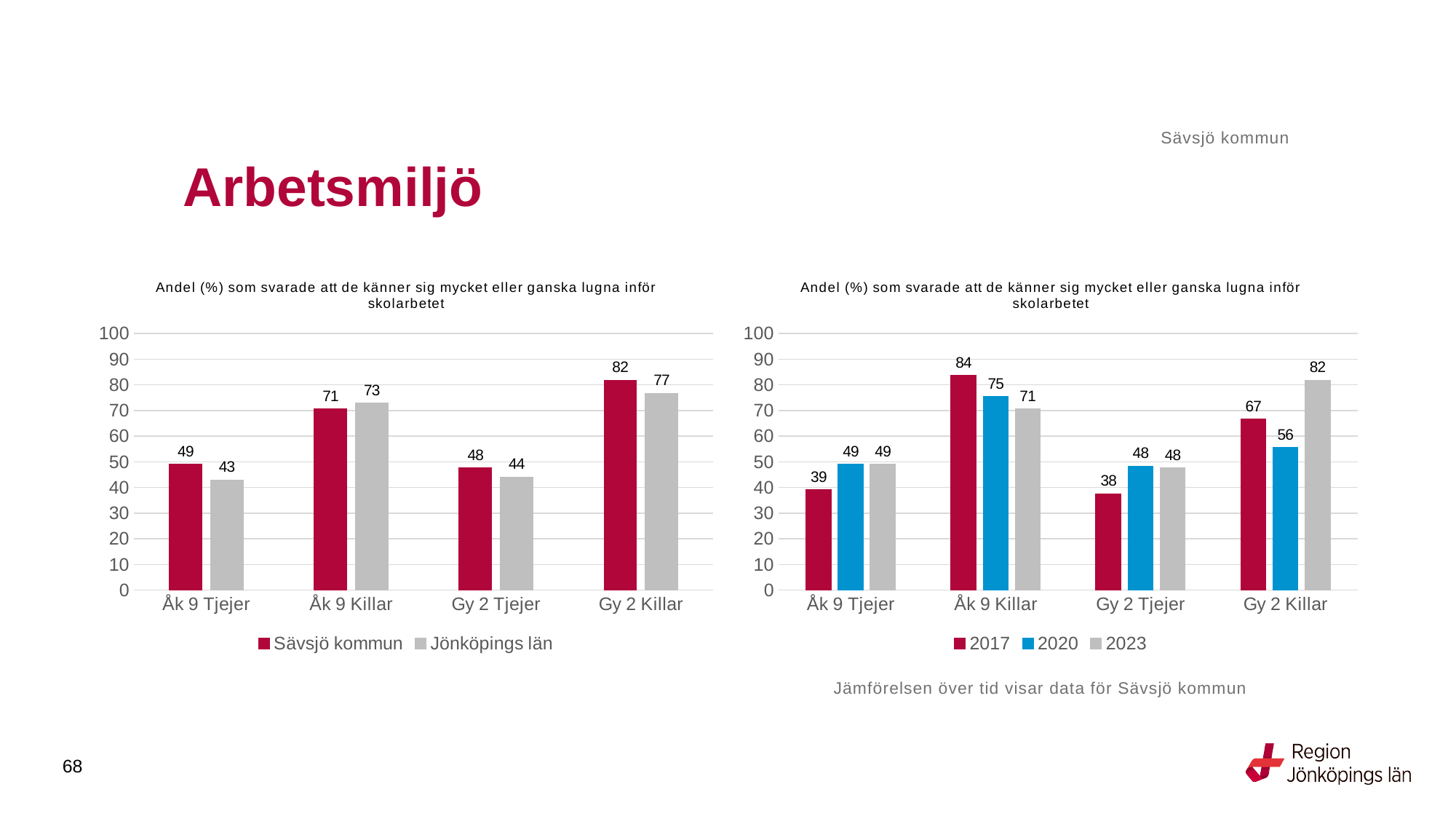
In the left chart, how many series does the legend list? 2 In the left chart, what is the value for Jönköpings län for Åk 9 Tjejer? 43 In the right chart, which category has the lowest value for 2017? Gy 2 Tjejer In the left chart, what is the difference between Sävsjö kommun and Jönköpings län for Gy 2 Killar? 5 In the right chart, what is the difference between 2017 and 2023 for Åk 9 Killar? 13 In the right chart, how many categories are shown on the x axis? 4 In the right chart, what is the value for 2023 for Gy 2 Killar? 82 In the left chart, what is the value for Sävsjö kommun for Gy 2 Killar? 82 In the left chart, which is larger for Åk 9 Killar: Sävsjö kommun or Jönköpings län? Jönköpings län In the right chart, what is the value for 2017 for Åk 9 Killar? 84 In the left chart, which category has the highest value for Sävsjö kommun? Gy 2 Killar What kind of chart is the right chart? Bar chart